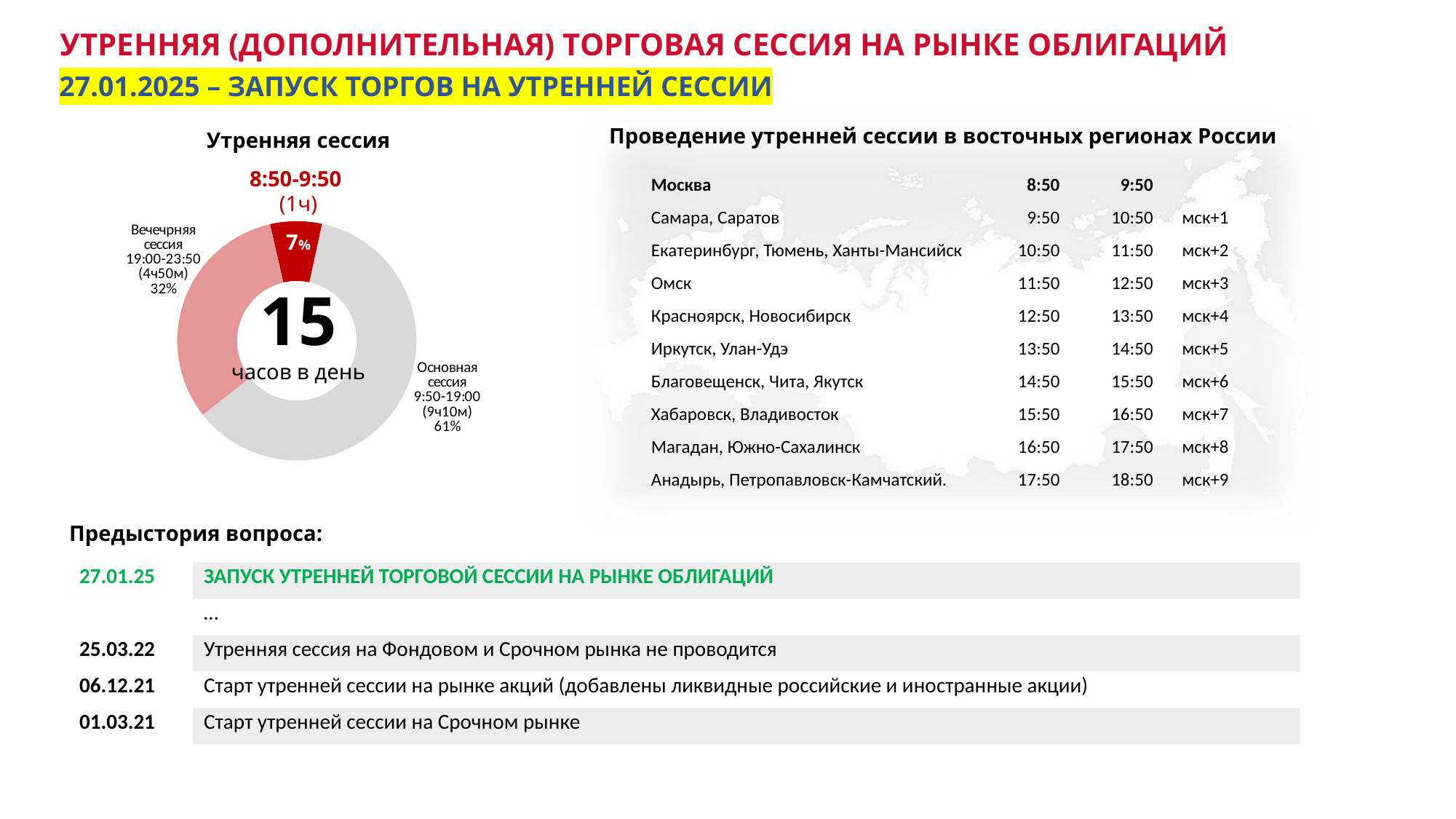
By how many percentage points does the "Основная сессия" share exceed the "Вечерняя сессия" share in the donut chart? 29 Which session has the largest slice in the donut chart? Основная сессия What number is displayed in the centre of the donut chart? 15 часов в день What duration is printed for the "Основная сессия" (9:50-19:00) in the donut chart label? 9ч10м Which session has the smallest slice in the donut chart? Утренняя сессия (8:50-9:50) What is the combined share of the three slices in the donut chart? 100% How many slices does the "Утренняя сессия" donut chart have? 3 What percentage is shown for the morning session (8:50-9:50) slice in the donut chart? 7% What share of the day does the "Основная сессия" slice represent in the donut chart? 61% What kind of chart is shown under the title "Утренняя сессия"? pie chart (donut) What share of the day does the "Вечерняя сессия" slice represent in the donut chart? 32% In the donut chart, which slice is larger: "Вечерняя сессия" or "Основная сессия"? Основная сессия